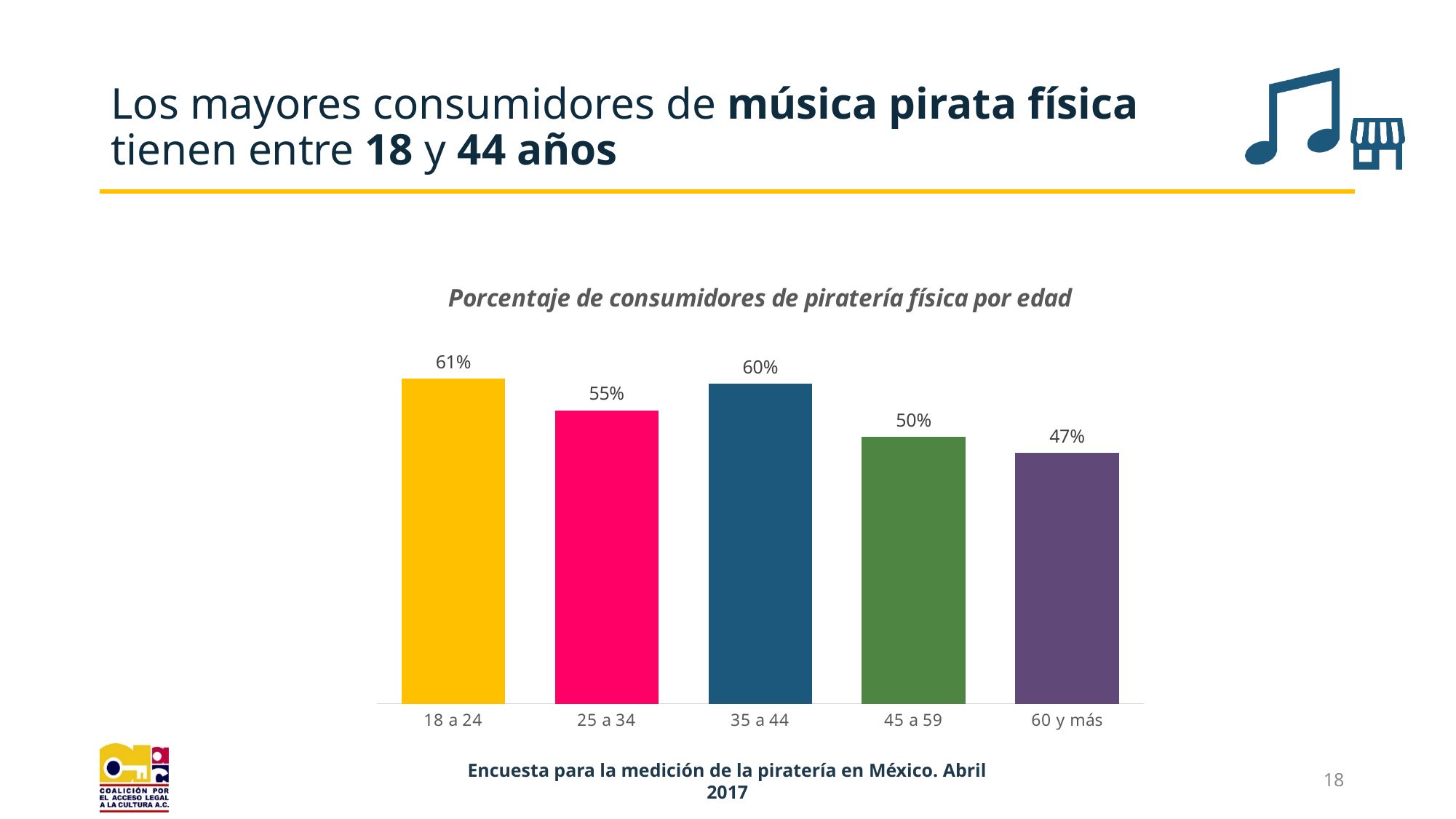
How many age groups are shown in the chart? 5 Which age group has the lowest percentage? 60 y más What colour is the bar for the 45 a 59 age group? Green Which is larger, the value for 25 a 34 or the value for 35 a 44? 35 a 44 What is the value for the 25 a 34 age group? 55% What is the value for the 60 y más age group? 47% What kind of chart is shown on the slide? Bar chart What is the value for the 18 a 24 age group? 61% What is the title of the chart? Porcentaje de consumidores de piratería física por edad What is the difference between the values for 35 a 44 and 45 a 59? 10% Which age group has the highest percentage? 18 a 24 What is the difference between the values for 18 a 24 and 60 y más? 14%